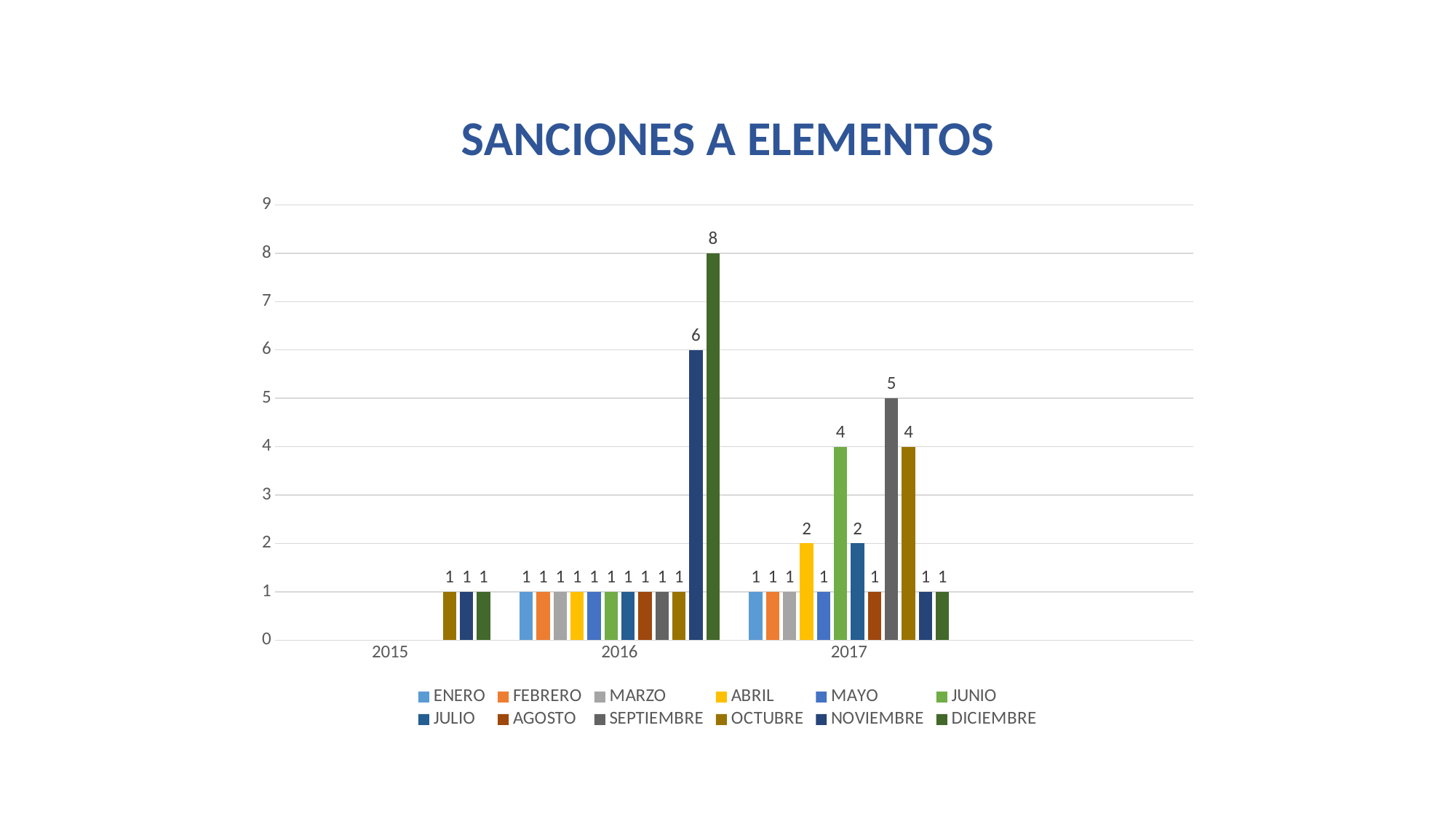
How many series does the legend list? 12 What is the value for OCTUBRE in 2017? 4 Which month has the highest value across the whole chart? DICIEMBRE (2016) How many year categories are shown on the x axis? 3 What is the value for NOVIEMBRE in 2016? 6 What is the difference between DICIEMBRE and NOVIEMBRE in 2016? 2 What is the title of the chart? SANCIONES A ELEMENTOS What type of chart is shown on the slide? bar chart Which month has the highest value in 2017? SEPTIEMBRE Which is larger in 2017, JUNIO or ABRIL? JUNIO What is the value for DICIEMBRE in 2016? 8 What is the value for SEPTIEMBRE in 2017? 5